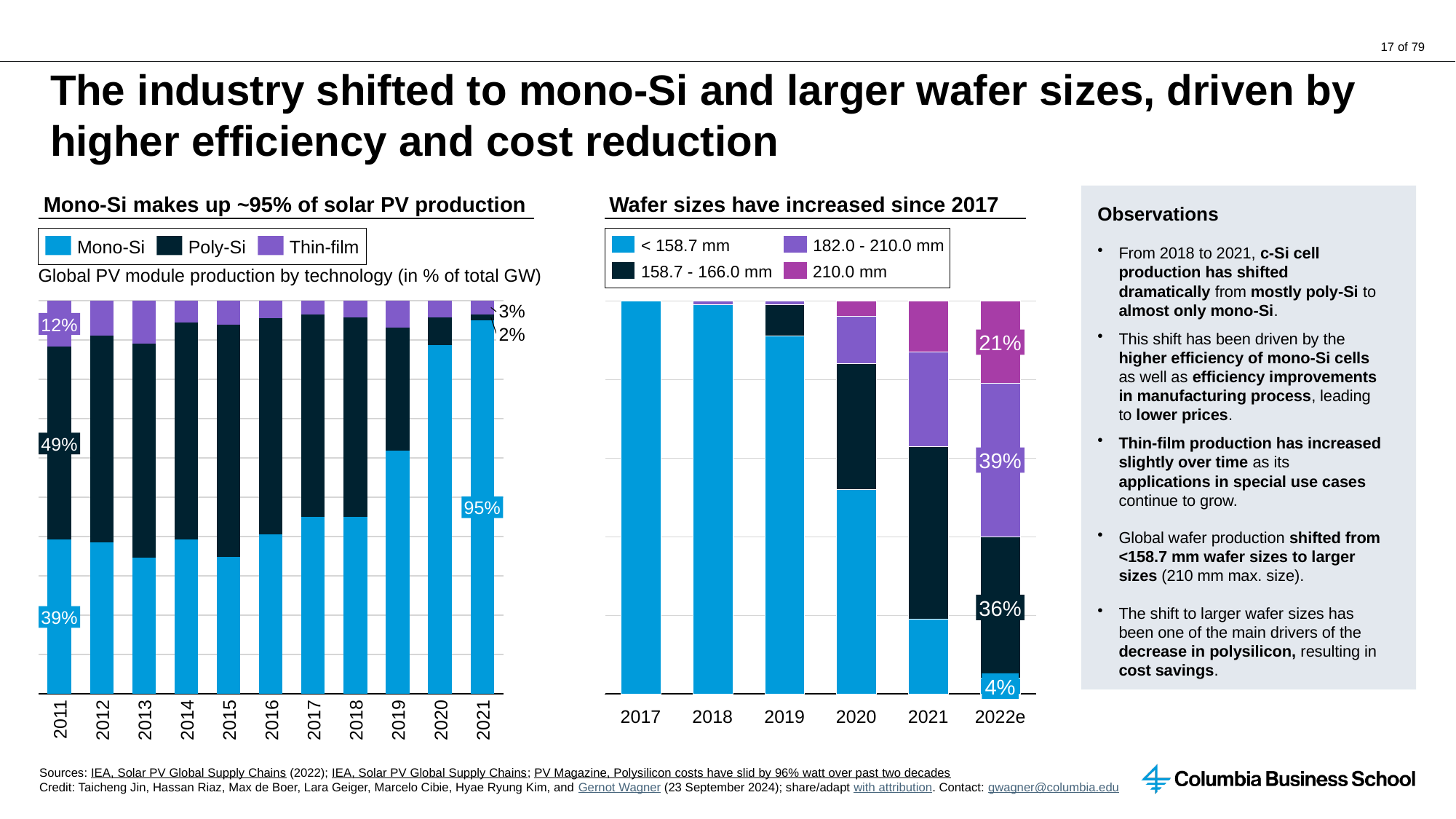
How many series does the legend of the chart titled "Wafer sizes have increased since 2017" list? 4 In the chart titled "Mono-Si makes up ~95% of solar PV production", what is the Thin-film share in 2021? 3% In the chart titled "Wafer sizes have increased since 2017", what is the share of < 158.7 mm wafers in 2022e? 4% In the chart titled "Mono-Si makes up ~95% of solar PV production", which was larger in 2011, the Mono-Si share or the Poly-Si share? Poly-Si In the chart titled "Mono-Si makes up ~95% of solar PV production", what is the Mono-Si share in 2021? 95% In the chart titled "Wafer sizes have increased since 2017", what is the share of 182.0 - 210.0 mm wafers in 2022e? 39% In the chart titled "Wafer sizes have increased since 2017", does the share of < 158.7 mm wafers rise or fall from 2017 to 2022e? Fall How many years are shown on the x axis of the chart titled "Mono-Si makes up ~95% of solar PV production"? 11 How many series does the legend of the chart titled "Mono-Si makes up ~95% of solar PV production" list? 3 In the chart titled "Mono-Si makes up ~95% of solar PV production", what is the Poly-Si share in 2011? 49% In the chart titled "Mono-Si makes up ~95% of solar PV production", by how many percentage points did the Mono-Si share increase from 2011 to 2021? 56 percentage points In the chart titled "Mono-Si makes up ~95% of solar PV production", what is the Mono-Si share in 2011? 39%